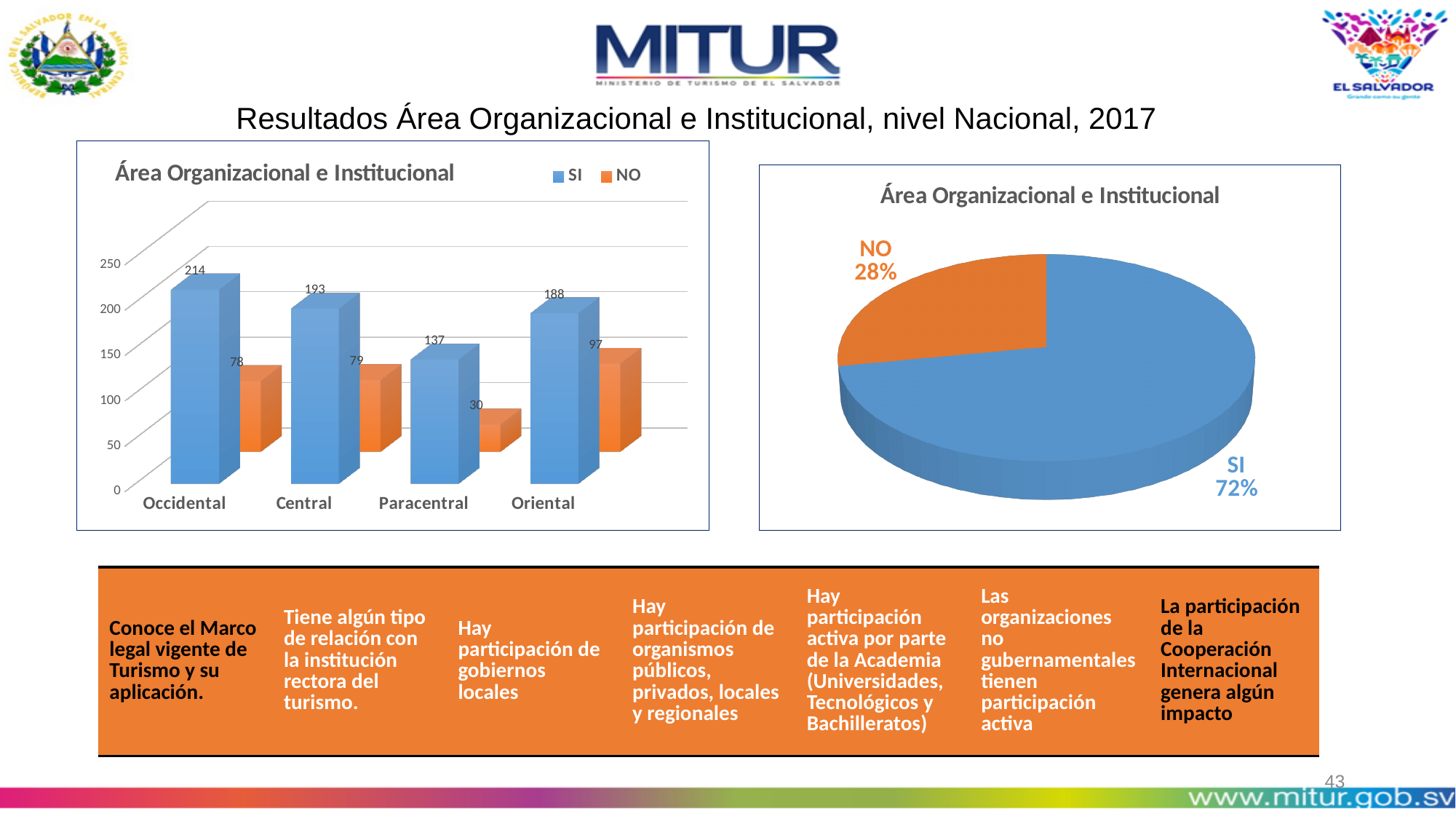
In the bar chart on the left, which region has the highest SI value? Occidental In the pie chart on the right, which slice is larger, SI or NO? SI In the bar chart on the left, what is the NO value for Paracentral? 30 In the bar chart on the left, what is the difference between the SI and NO values for Central? 114 In the pie chart on the right, what share does the NO slice represent? 28% In the bar chart on the left, which region has the lowest NO value? Paracentral In the bar chart on the left, how many series does the legend list? 2 In the bar chart on the left, which is larger: the SI value for Central or the SI value for Oriental? Central In the bar chart on the left, what is the SI value for Occidental? 214 In the bar chart on the left, how many regions are shown on the x axis? 4 What kind of chart is the chart on the right? pie chart In the bar chart on the left, what is the NO value for Oriental? 97